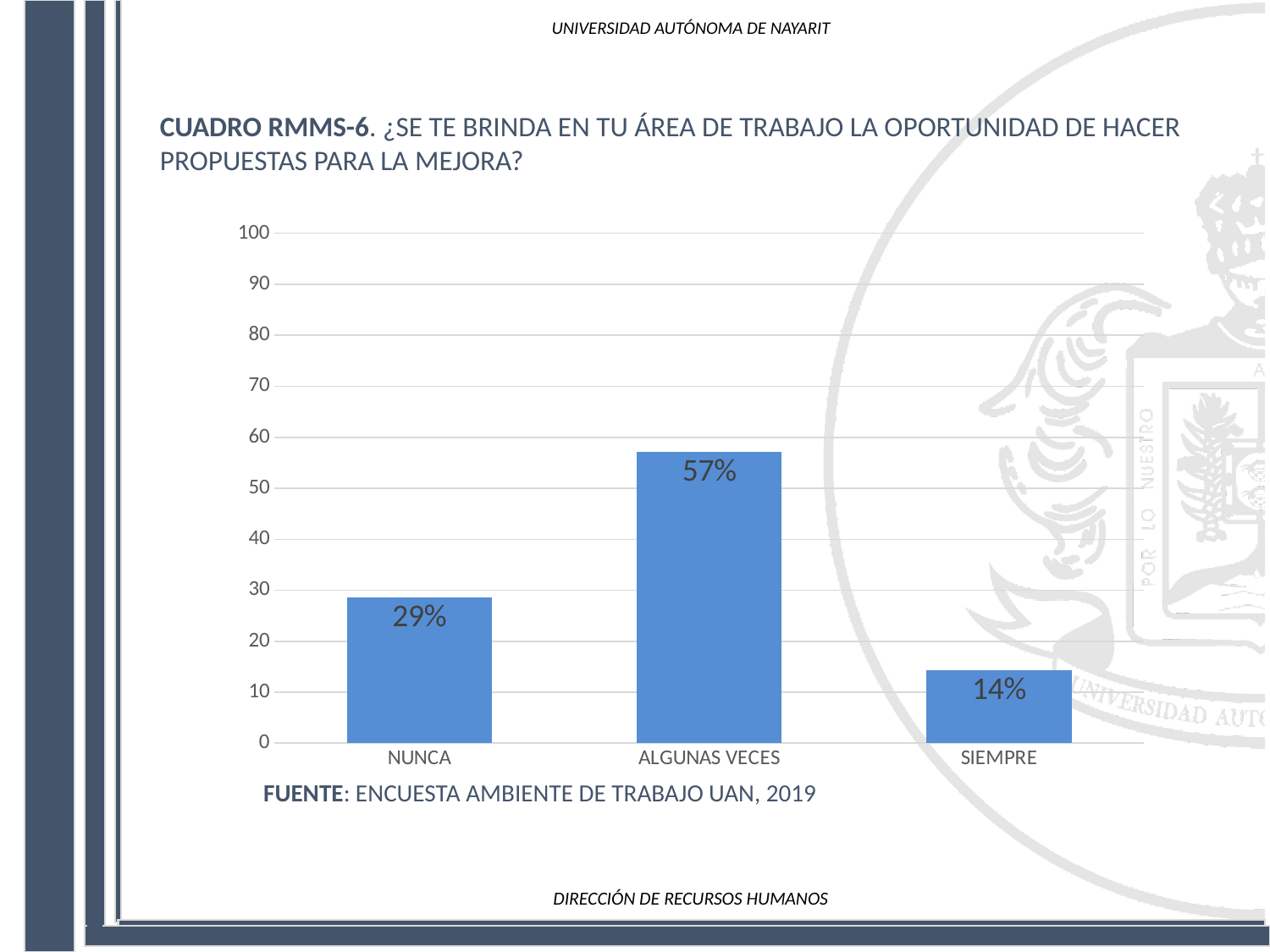
What kind of chart is shown on the slide? bar chart How many categories are shown on the x axis? 3 Which is larger, the value for NUNCA or the value for SIEMPRE? NUNCA Is the value for ALGUNAS VECES greater or less than 50? greater What source is cited below the chart? ENCUESTA AMBIENTE DE TRABAJO UAN, 2019 What is the value for NUNCA? 29% What is the difference between the values for ALGUNAS VECES and NUNCA? 28% What is the difference between the values for NUNCA and SIEMPRE? 15% What is the value for ALGUNAS VECES? 57% What is the value for SIEMPRE? 14% Which category has the lowest value? SIEMPRE Which category has the highest value? ALGUNAS VECES